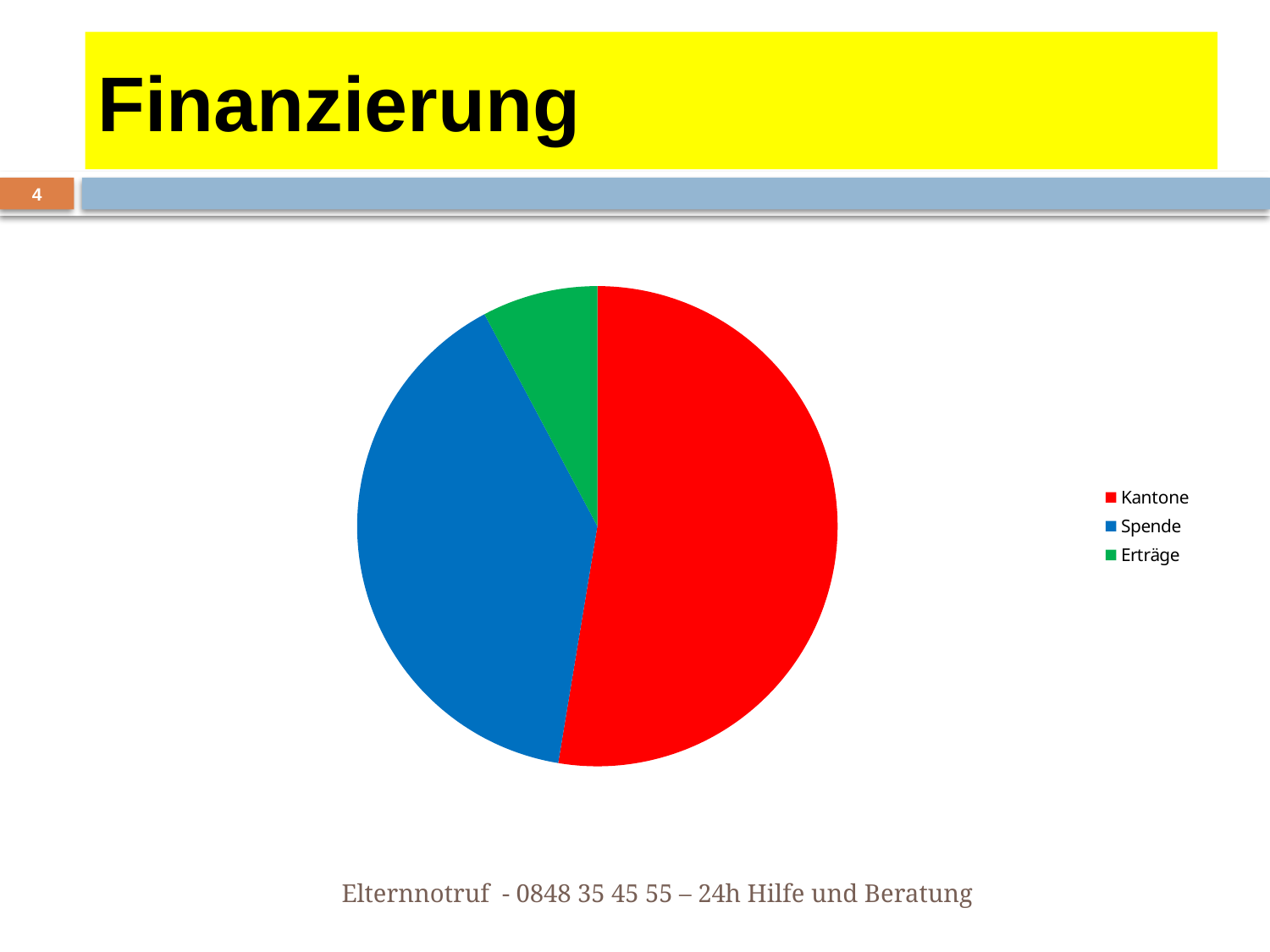
Which category is shown in green in the pie chart? Erträge What kind of chart is shown on the slide? pie chart Which slice is larger in the pie chart, Spende or Erträge? Spende How many slices does the pie chart have? 3 Which slice is smaller in the pie chart, Kantone or Erträge? Erträge What colour is the Spende slice in the pie chart? blue Which slice is larger in the pie chart, Kantone or Spende? Kantone Which category has the smallest slice of the pie chart? Erträge How many entries does the legend of the pie chart list? 3 Which category has the largest slice of the pie chart? Kantone